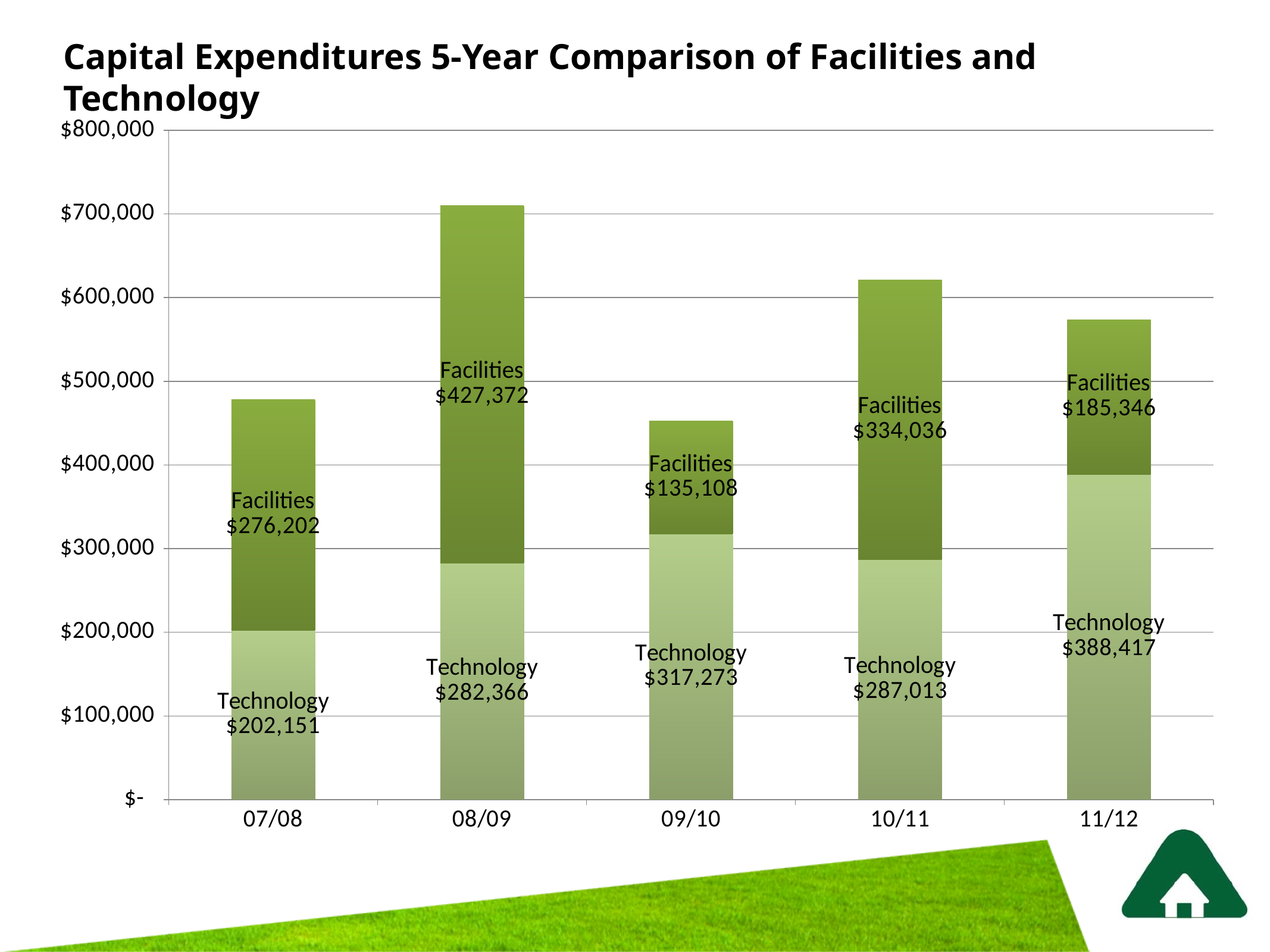
What is the Facilities value for 09/10? $135,108 What kind of chart is shown? Stacked bar chart What is the total of the stacked bar for 07/08? $478,353 What is the difference between the Facilities values for 08/09 and 09/10? $292,264 What is the title of the chart? Capital Expenditures 5-Year Comparison of Facilities and Technology How many years are shown on the x axis? 5 Which is larger in 10/11, Facilities or Technology? Facilities What is the Facilities value for 08/09? $427,372 Is the total stacked bar for 08/09 greater or less than $700,000? greater Which year has the highest Facilities expenditure? 08/09 What is the Technology value for 11/12? $388,417 Which year has the lowest Technology expenditure? 07/08